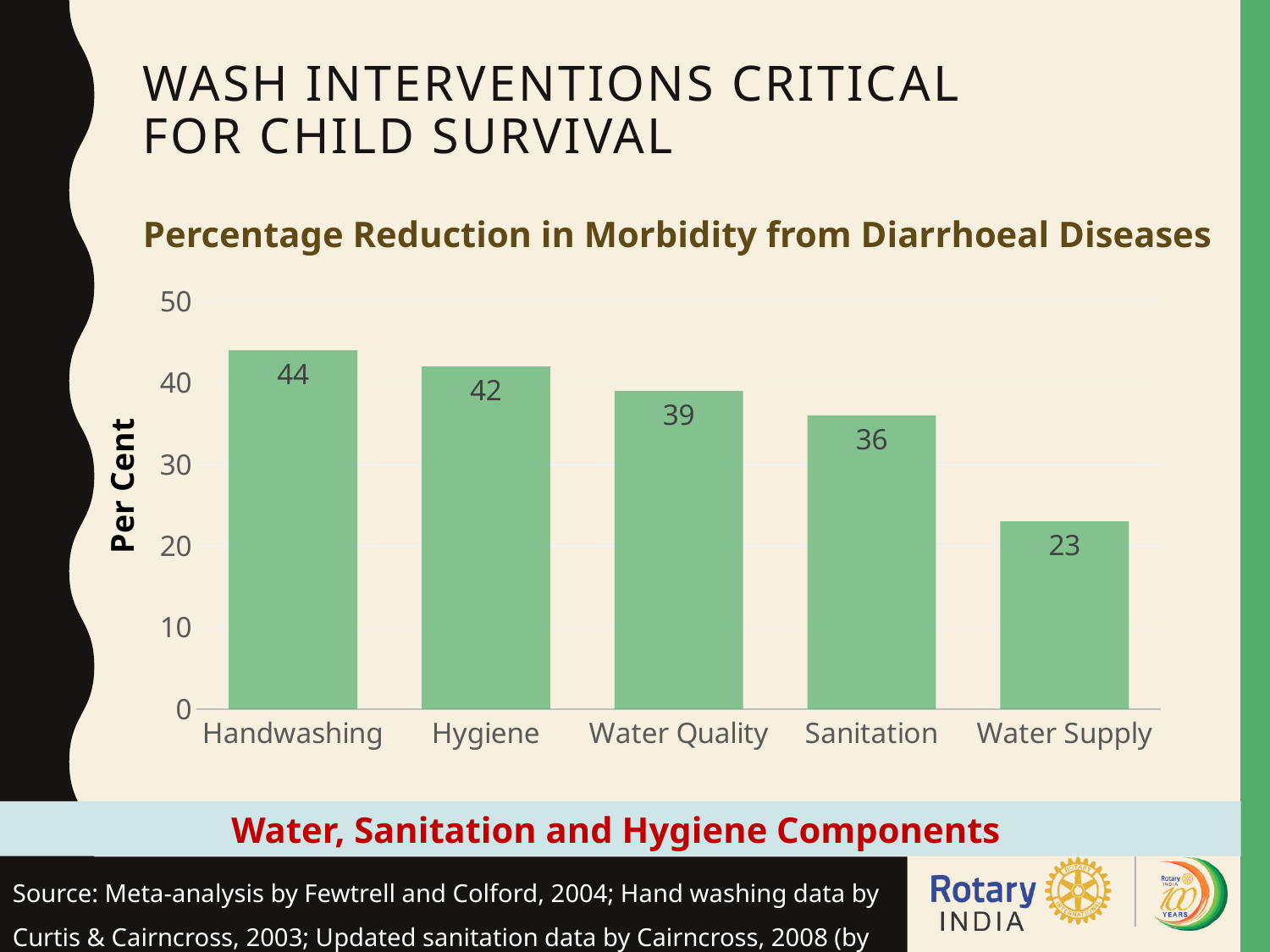
What is the value shown for Water Supply? 23 What is the difference between the values for Handwashing and Water Supply? 21 Is the value for Hygiene greater or less than 40? greater What is the value shown for Sanitation? 36 Which component has the lowest percentage reduction in morbidity? Water Supply Which component has the highest percentage reduction in morbidity? Handwashing How many components are shown on the x axis? 5 Which has a larger value, Water Quality or Sanitation? Water Quality What kind of chart is shown on the slide? Bar chart What is the label of the y axis? Per Cent What is the percentage reduction in morbidity for Handwashing? 44 What is the difference between the values for Hygiene and Water Quality? 3